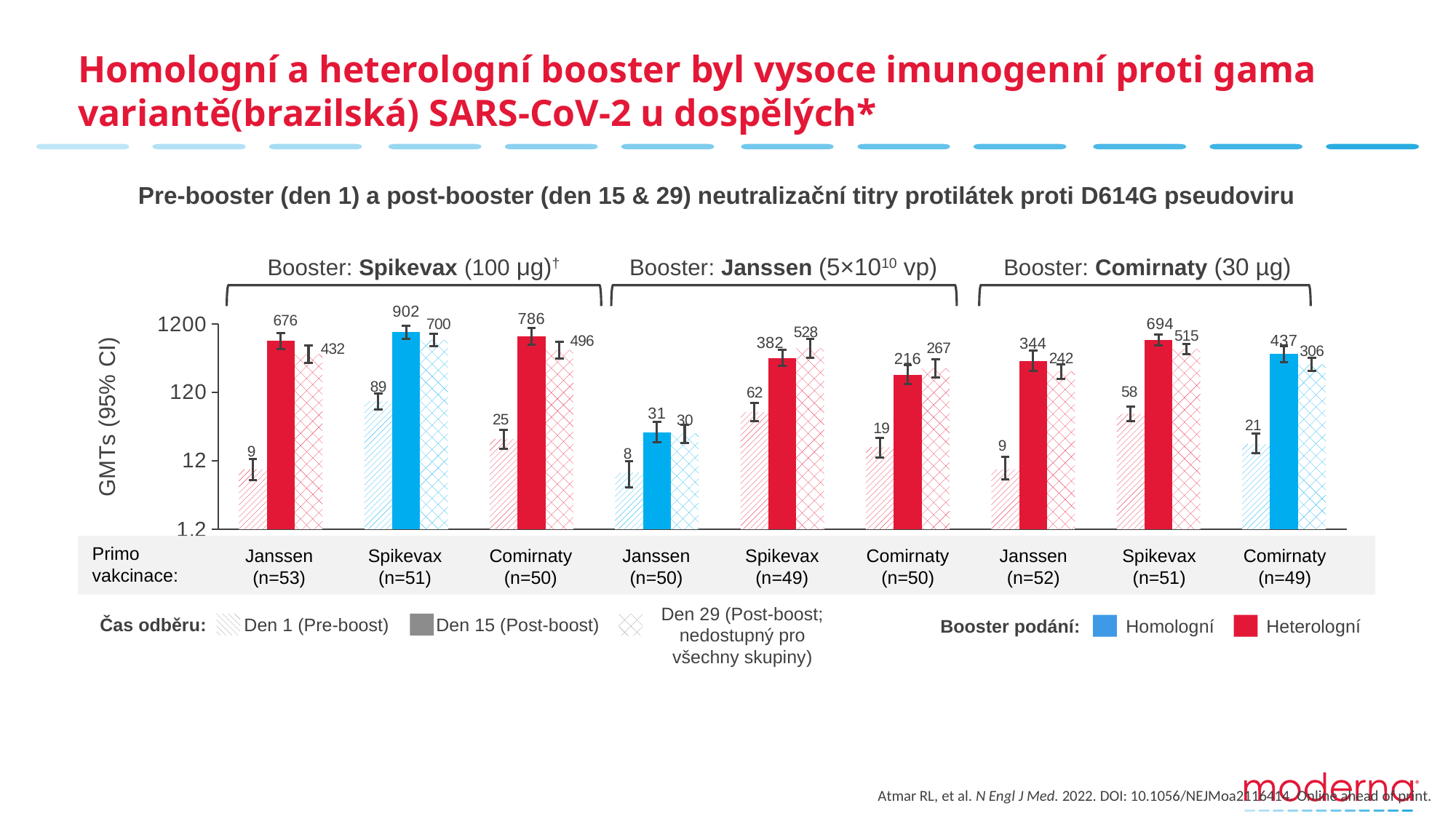
How many sampling time points (Čas odběru) does the legend list? 3 How many primo vaccination groups are shown along the x axis of the chart? 9 What is the Day 15 (Post-boost) GMT for the Janssen primo vaccination group with the Spikevax booster? 676 Which is larger: the Day 15 GMT for the Comirnaty primo group with the Spikevax booster, or the Day 15 GMT for the Comirnaty primo group with the Comirnaty booster? Spikevax booster (786) Which primo vaccination and booster combination has the lowest Day 15 (Post-boost) GMT? Janssen primo vaccination with Janssen booster (31) For the Janssen primo vaccination group with the Janssen booster, do the GMTs rise or fall from Day 1 to Day 15? Rise Which primo vaccination and booster combination has the highest Day 15 (Post-boost) GMT? Spikevax primo vaccination with Spikevax booster (902) What is the Day 1 (Pre-boost) GMT for the Comirnaty primo vaccination group with the Comirnaty booster? 21 What colour represents a homologous (Homologní) booster in the chart? Blue What kind of chart is shown on the slide? Bar chart What is the difference between the Day 15 GMT and the Day 1 GMT for the Spikevax primo vaccination group with the Comirnaty booster? 636 What is the Day 29 (Post-boost) GMT for the Spikevax primo vaccination group with the Janssen booster? 528